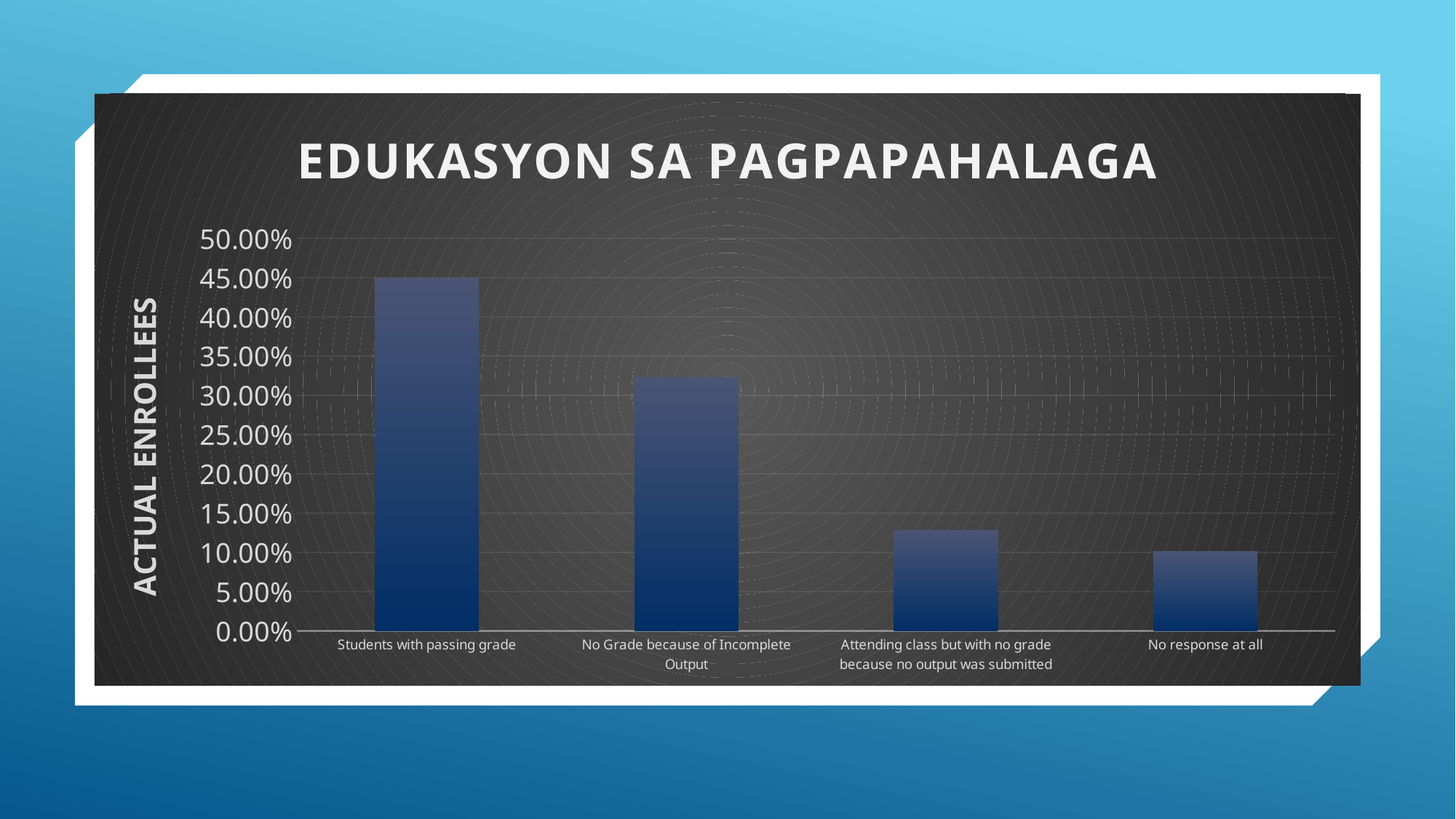
Which category has the lowest value? No response at all What kind of chart is shown on the slide? bar chart Do the values rise or fall from left to right across the categories? fall Is the value for No Grade because of Incomplete Output greater or less than 30.00%? greater What is the title of the chart? EDUKASYON SA PAGPAPAHALAGA Which category has the highest value? Students with passing grade What is the label on the vertical axis of the chart? ACTUAL ENROLLEES Which is larger: the value for No Grade because of Incomplete Output or the value for Attending class but with no grade because no output was submitted? No Grade because of Incomplete Output Is the value for Attending class but with no grade because no output was submitted greater or less than 15.00%? less How many categories are plotted in the chart? 4